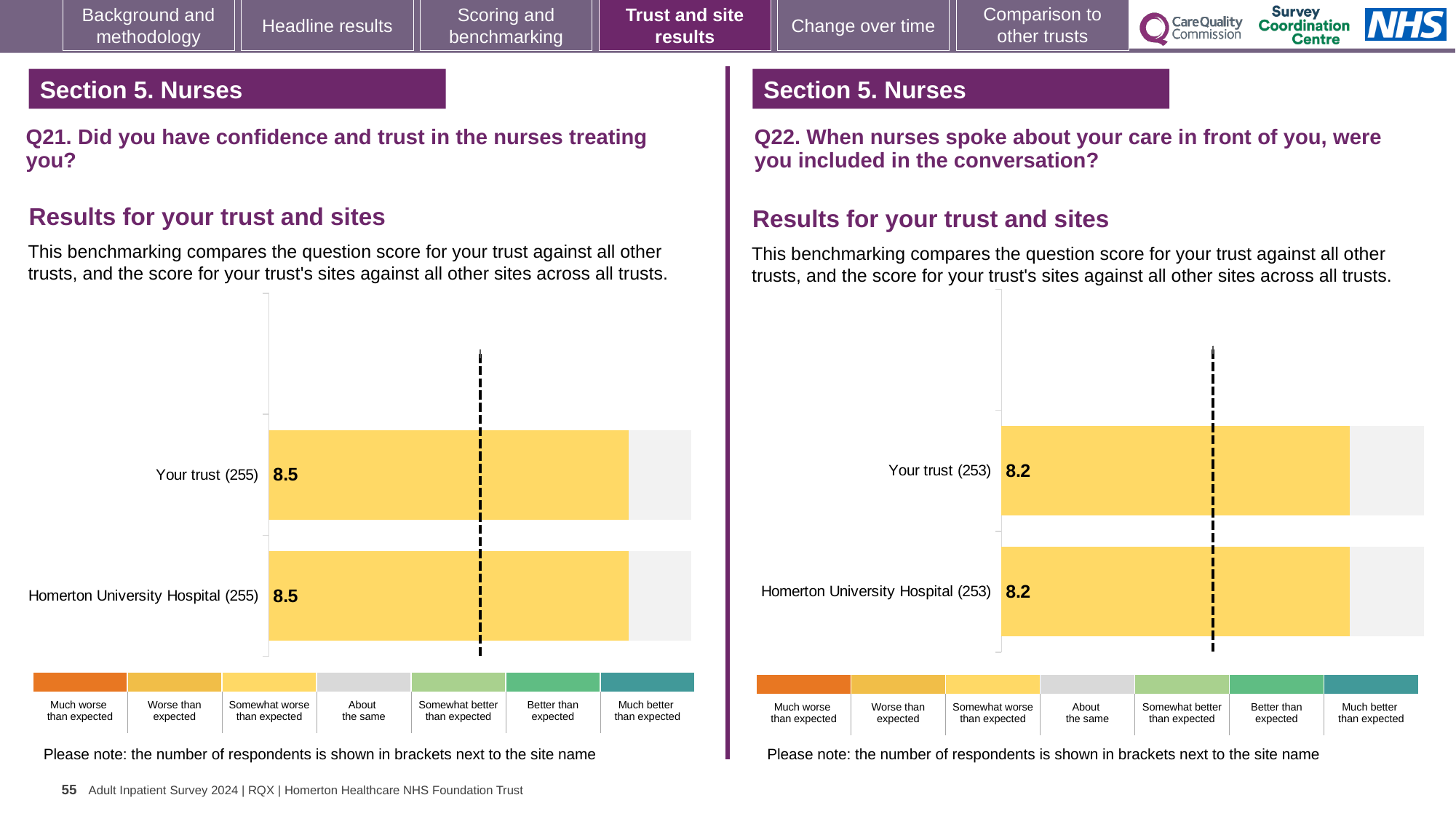
In the Q22 chart on the right, what is the score for Your trust? 8.2 In the Q21 chart on the left, what is the score for Your trust? 8.5 In the Q21 chart on the left, what is the score for Homerton University Hospital? 8.5 In the Q21 chart on the left, how many respondents are shown in brackets for Your trust? 255 In the Q22 chart on the right, what is the score for Homerton University Hospital? 8.2 How many bars are plotted in the Q21 chart on the left? 2 In the Q22 chart on the right, what is the difference between the score for Your trust and the score for Homerton University Hospital? 0 How many bars are plotted in the Q22 chart on the right? 2 In the Q21 chart on the left, what is the difference between the score for Your trust and the score for Homerton University Hospital? 0 Is the score for Your trust in the Q22 chart on the right larger or smaller than the score for Your trust in the Q21 chart on the left? Smaller In the Q22 chart on the right, how many respondents are shown in brackets for Homerton University Hospital? 253 What kind of chart is used for the Q21 results on the left? Bar chart